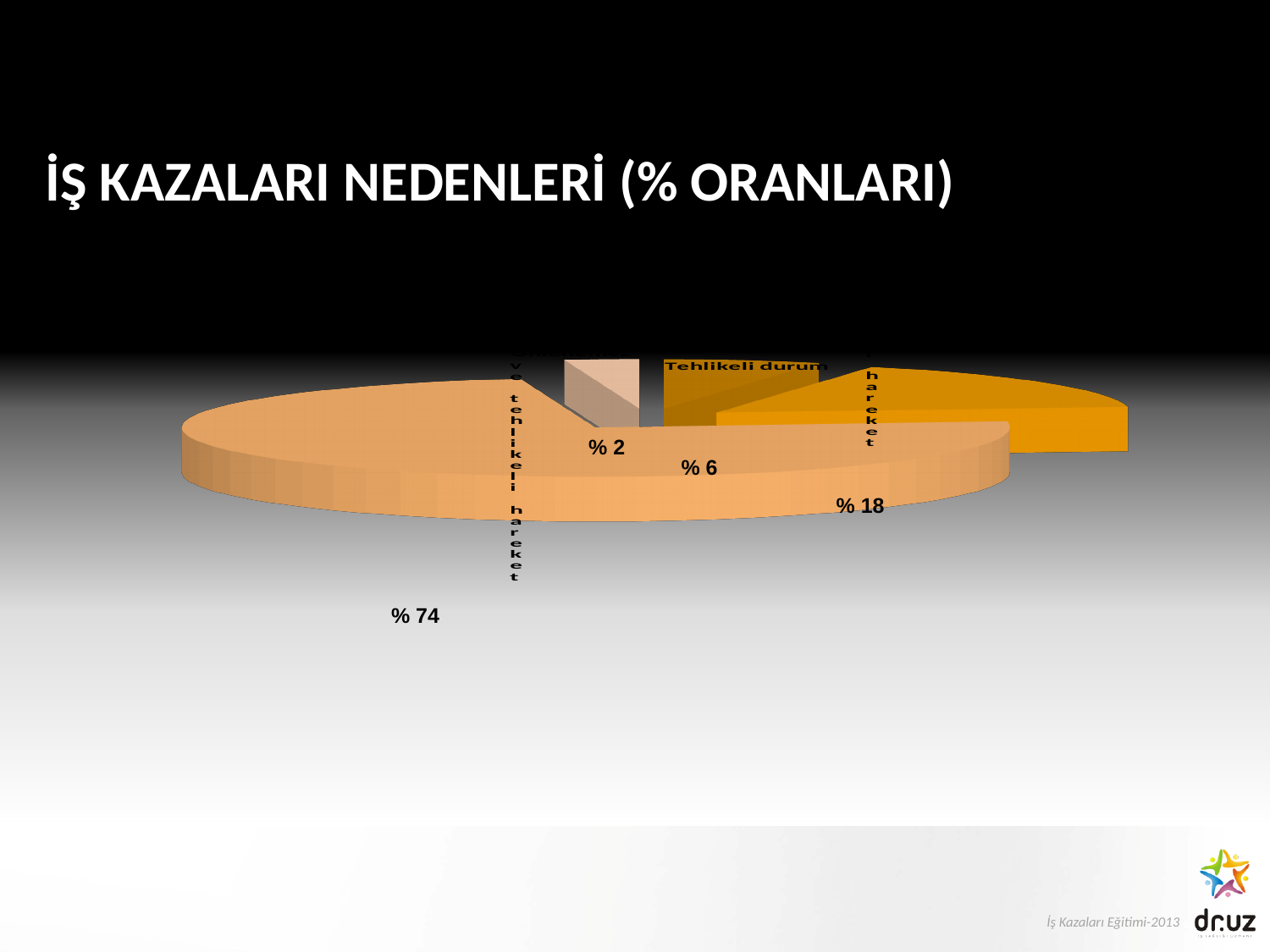
What kind of chart is shown on the slide? pie chart What is the title of the slide containing the pie chart? İŞ KAZALARI NEDENLERİ (% ORANLARI) What is the value of the largest slice in the pie chart? % 74 Which is larger, the % 18 slice or the % 6 slice? % 18 What is the difference between the largest slice (% 74) and the second largest slice (% 18)? % 56 What is the value of the smallest slice in the pie chart? % 2 How many slices does the pie chart have? 4 What is the difference between the % 6 slice and the % 2 slice? % 4 Is the largest slice of the pie chart greater or less than 50%? greater What is the total of all the slice values shown in the pie chart? % 100